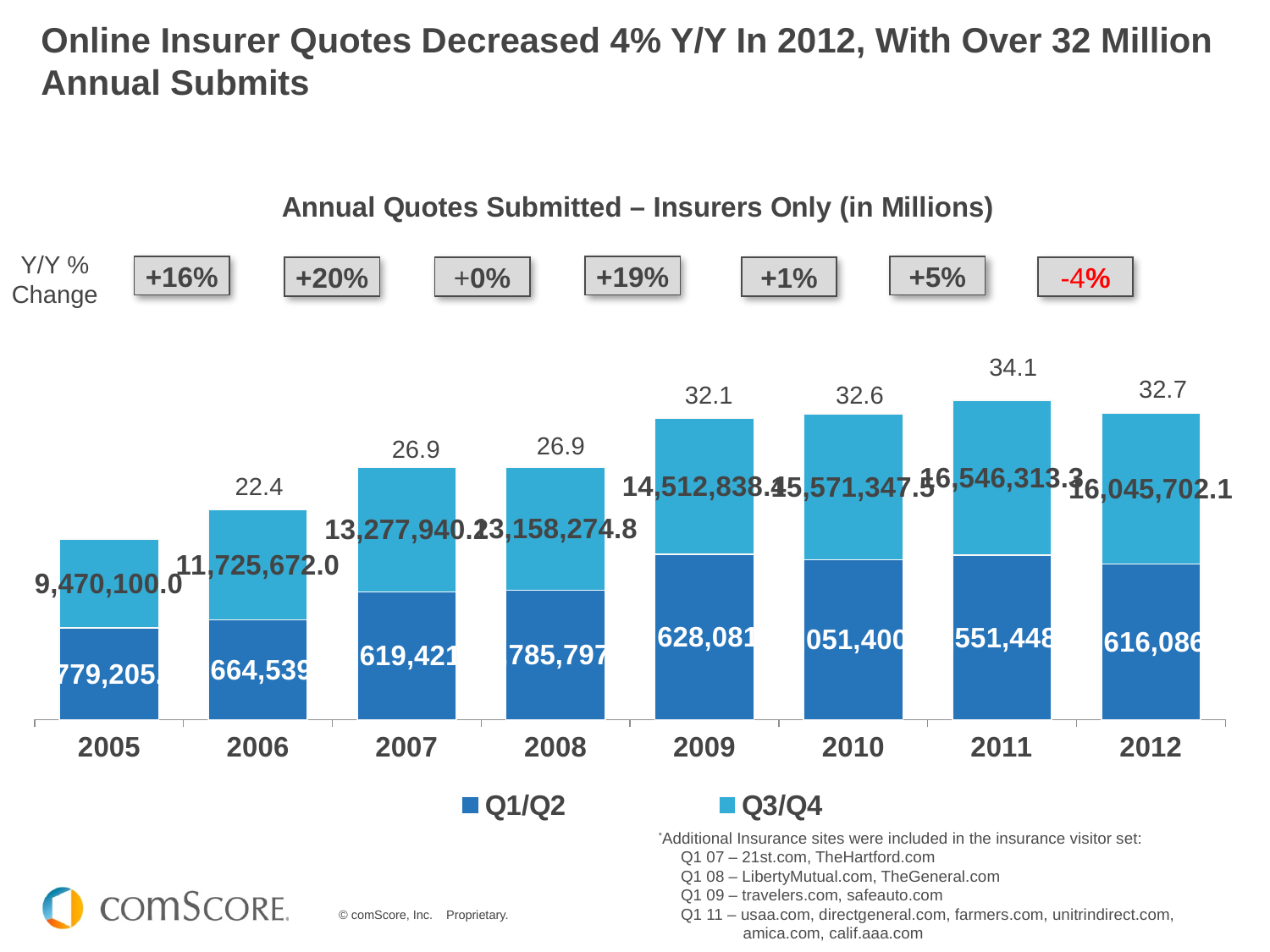
What is the title of the chart? Annual Quotes Submitted – Insurers Only (in Millions) Which year has a larger total, 2009 or 2010? 2010 What is the Y/Y % change shown for 2012? -4% How many series does the chart legend list? 2 Which year has the highest total annual quotes submitted? 2011 What is the total annual quotes submitted (in millions) for 2012? 32.7 What is the Q3/Q4 value for 2005? 9,470,100.0 How many years are shown on the x axis of the chart? 8 What is the total annual quotes submitted (in millions) for 2011? 34.1 What is the difference between the total for 2011 and the total for 2012 (in millions)? 1.4 What is the Q3/Q4 value for 2006? 11,725,672.0 What kind of chart is shown on the slide? Stacked bar chart